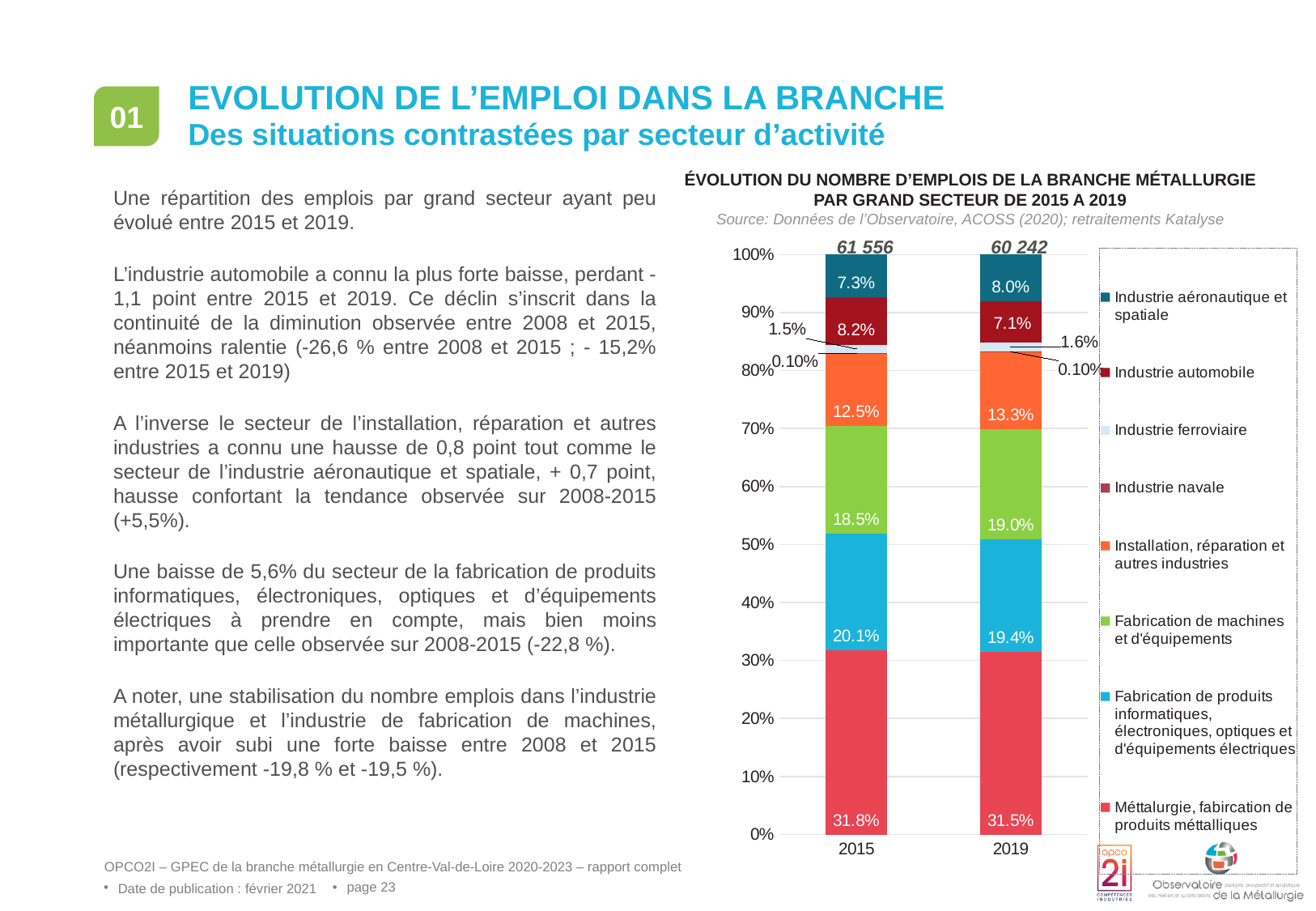
What is the share of 'Industrie automobile' in 2019? 7.1% What total number of jobs is printed above the 2019 bar? 60 242 What is the share of 'Méttalurgie, fabircation de produits méttalliques' in 2015? 31.8% What is the share of 'Installation, réparation et autres industries' in 2019? 13.3% Is the share of 'Fabrication de machines et d'équipements' larger in 2015 or in 2019? 2019 How many years (bars) are shown on the x axis? 2 What kind of chart is shown on the slide? Stacked bar chart By how many percentage points did the share of 'Industrie automobile' change between 2015 (8.2%) and 2019 (7.1%)? 1.1 points Which sector has the smallest share in the 2015 bar? Industrie navale How many series does the legend list? 8 What is the share of 'Industrie aéronautique et spatiale' in 2015? 7.3% Which sector has the largest share in the 2019 bar? Méttalurgie, fabircation de produits méttalliques